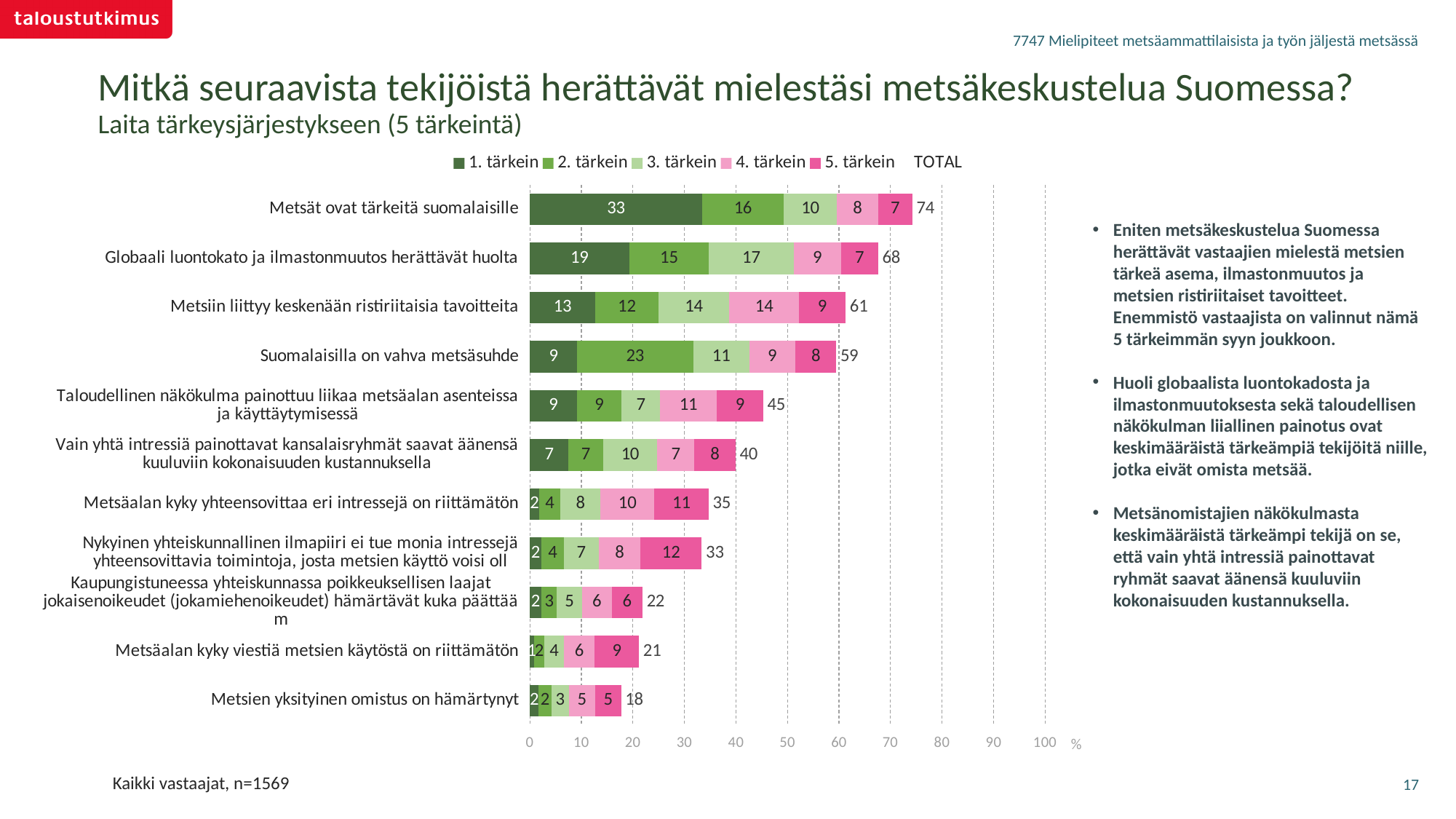
Which category has the lowest TOTAL? Metsien yksityinen omistus on hämärtynyt Which category has the highest TOTAL? Metsät ovat tärkeitä suomalaisille How many series does the legend list (excluding TOTAL)? 5 What kind of chart is shown on the slide? Stacked bar chart What is the '2. tärkein' value for 'Suomalaisilla on vahva metsäsuhde'? 23 How many categories (statements) are plotted in the chart? 11 What is the '5. tärkein' value for 'Nykyinen yhteiskunnallinen ilmapiiri ei tue monia intressejä yhteensovittavia toimintoja, josta metsien käyttö voisi oll'? 12 What is the sample size stated below the chart? n=1569 Which has a larger '3. tärkein' value: 'Globaali luontokato ja ilmastonmuutos herättävät huolta' or 'Metsiin liittyy keskenään ristiriitaisia tavoitteita'? Globaali luontokato ja ilmastonmuutos herättävät huolta What is the difference between the '1. tärkein' values for 'Metsät ovat tärkeitä suomalaisille' and 'Globaali luontokato ja ilmastonmuutos herättävät huolta'? 14 What is the '1. tärkein' value for 'Metsät ovat tärkeitä suomalaisille'? 33 What is the TOTAL shown for 'Globaali luontokato ja ilmastonmuutos herättävät huolta'? 68